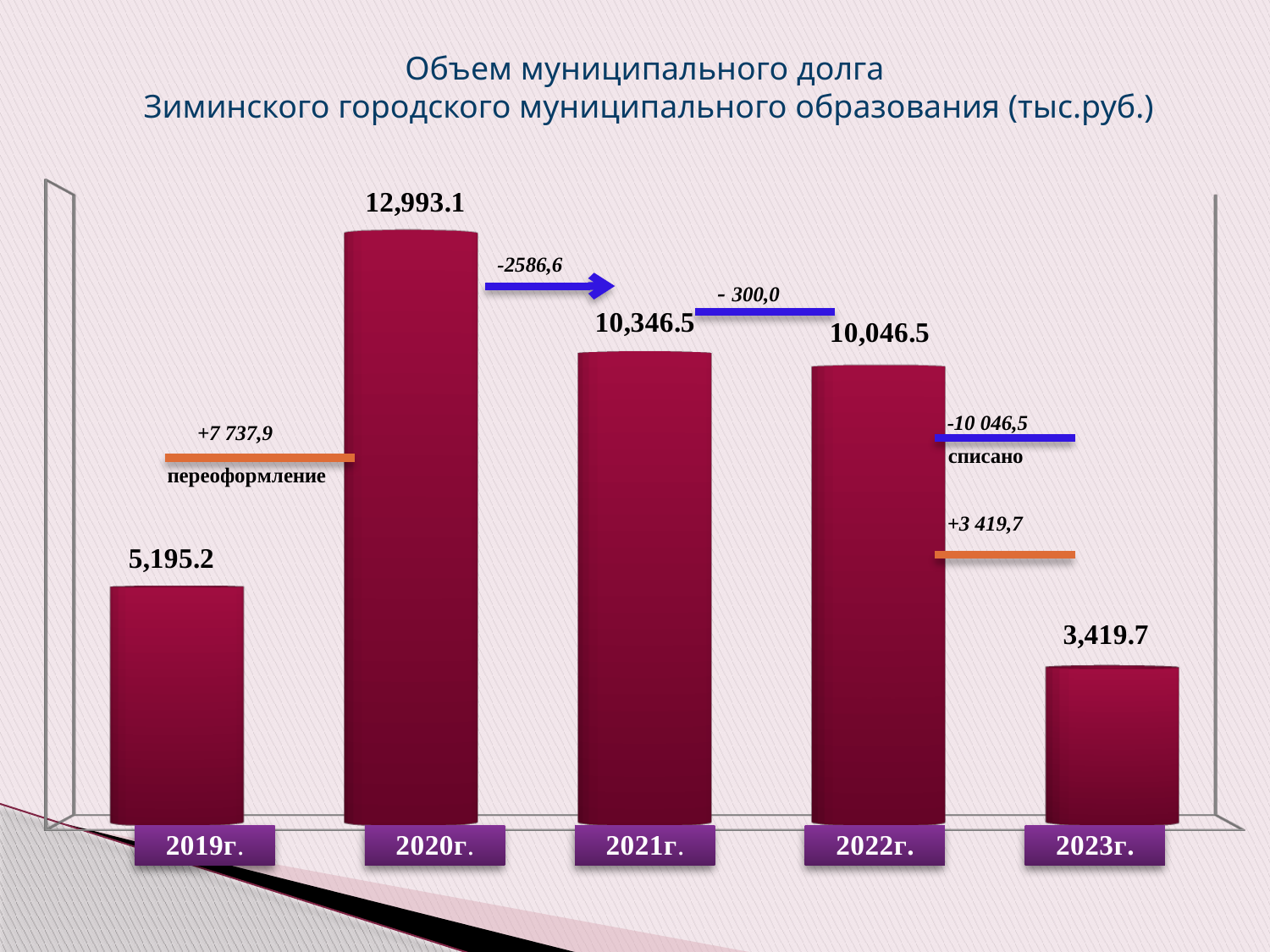
What is the value for 2023г.? 3,419.7 What is the value for 2020г.? 12,993.1 Which is larger, the value for 2019г. or the value for 2023г.? 2019г. How many years are shown on the chart? 5 What is the value for 2019г.? 5,195.2 What is the value for 2022г.? 10,046.5 Which year has the highest value? 2020г. What is the difference between the values for 2021г. and 2022г.? 300.0 What unit is given in the chart title? тыс.руб. What kind of chart is shown on the slide? Bar chart What is the difference between the values for 2020г. and 2021г.? 2,646.6 Which year has the lowest value? 2023г.